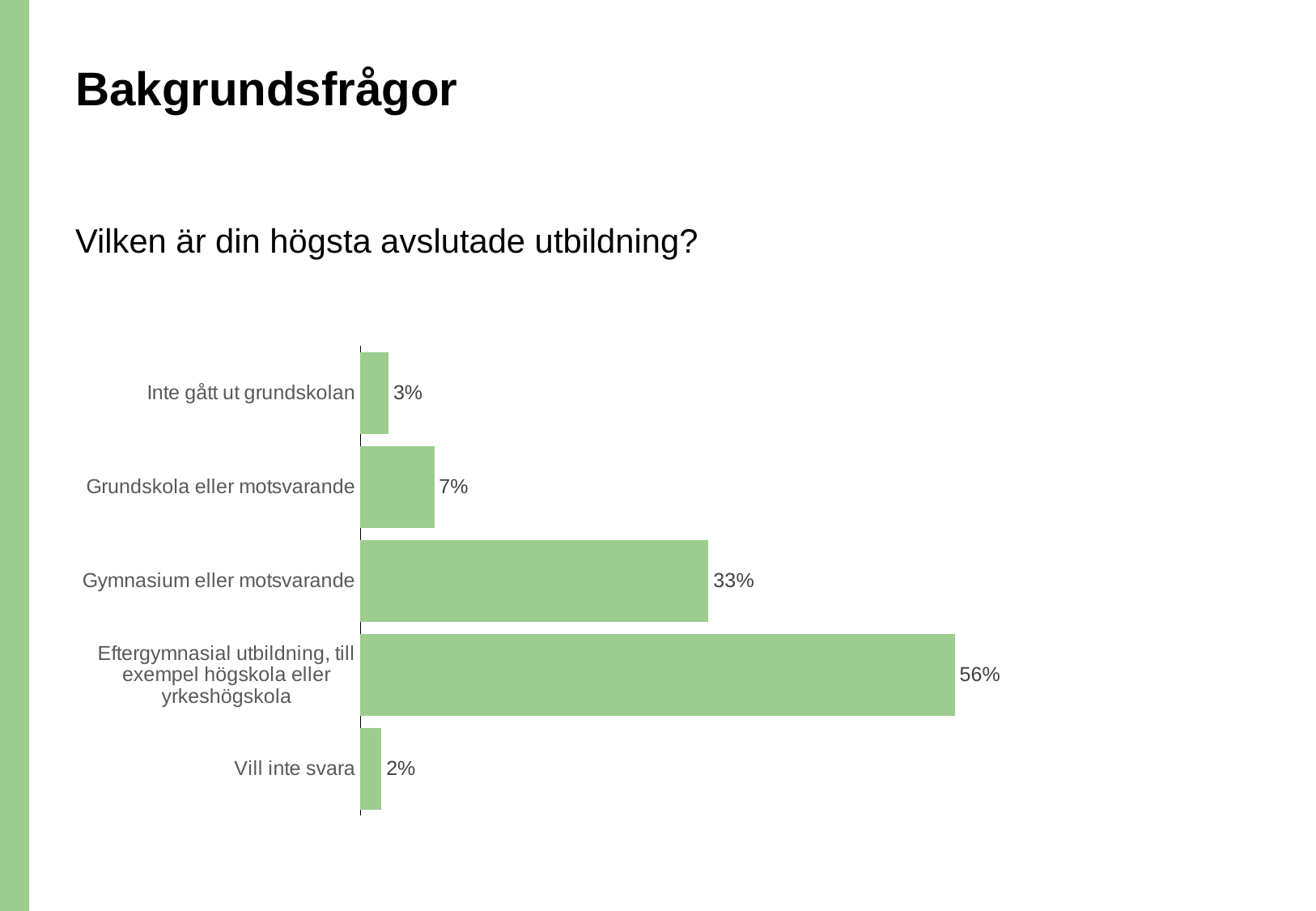
What question does the chart answer, as written above it? Vilken är din högsta avslutade utbildning? What kind of chart is shown on the slide? Bar chart What is the value for "Eftergymnasial utbildning, till exempel högskola eller yrkeshögskola"? 56% What is the value for "Inte gått ut grundskolan"? 3% What is the difference between the values for "Eftergymnasial utbildning, till exempel högskola eller yrkeshögskola" and "Gymnasium eller motsvarande"? 23% What is the value for "Vill inte svara"? 2% What is the difference between the values for "Grundskola eller motsvarande" and "Inte gått ut grundskolan"? 4% Which category has the lowest value? Vill inte svara How many categories are shown in the chart? 5 Which category has the highest value? Eftergymnasial utbildning, till exempel högskola eller yrkeshögskola Which is larger, the value for "Grundskola eller motsvarande" or the value for "Vill inte svara"? Grundskola eller motsvarande What is the value for "Gymnasium eller motsvarande"? 33%